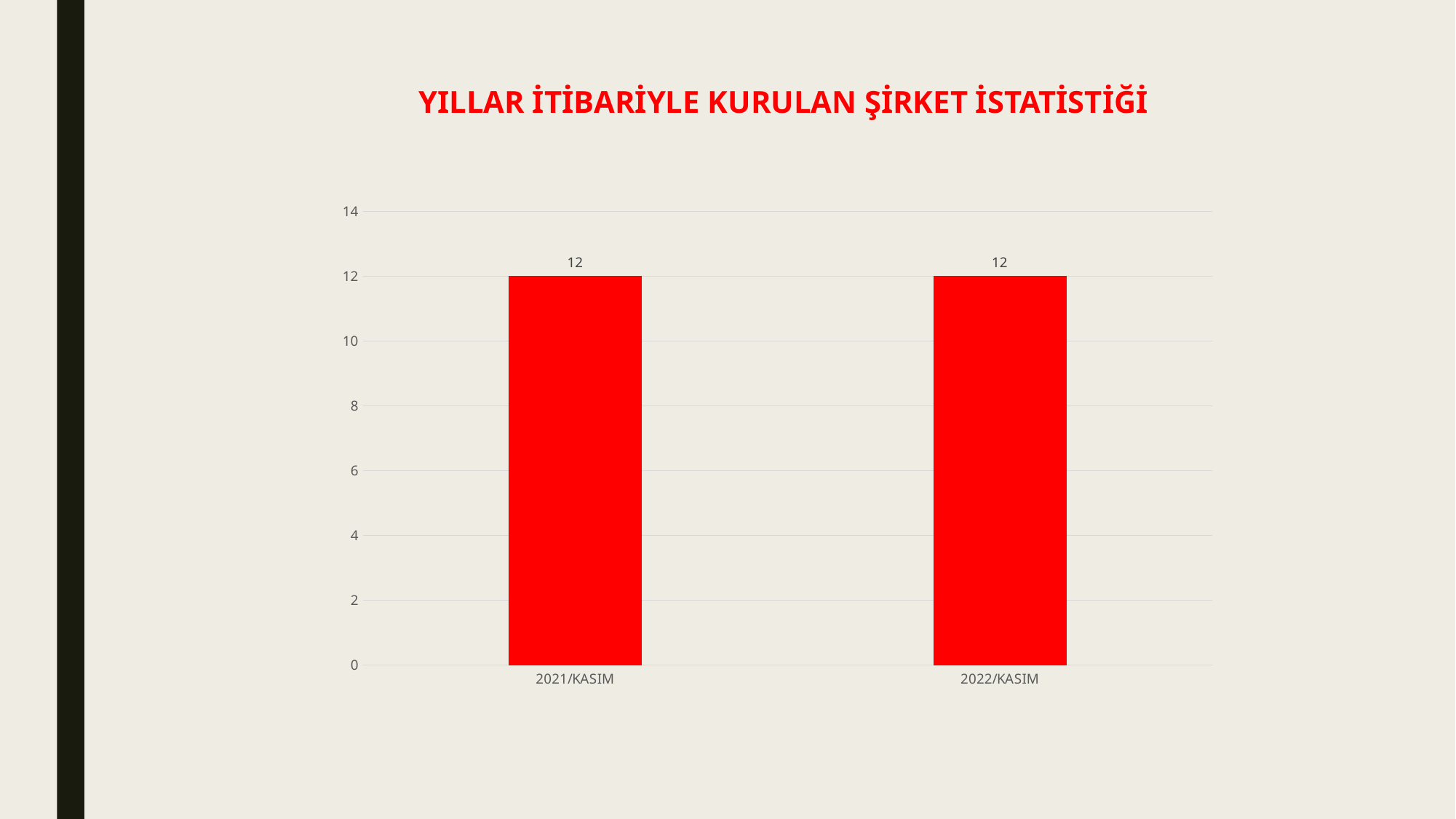
Is the value for 2021/KASIM greater or less than 10? greater What kind of chart is shown on the slide? bar chart How many categories are shown on the x axis? 2 Do the values rise, fall or stay the same from 2021/KASIM to 2022/KASIM? stay the same What is the difference between the values for 2021/KASIM and 2022/KASIM? 0 What is the value for 2022/KASIM? 12 What is the highest value shown on the y axis? 14 What colour are the bars in the chart? red What is the title of the chart? YILLAR İTİBARİYLE KURULAN ŞİRKET İSTATİSTİĞİ What is the value for 2021/KASIM? 12 Is the value for 2022/KASIM greater or less than 14? less